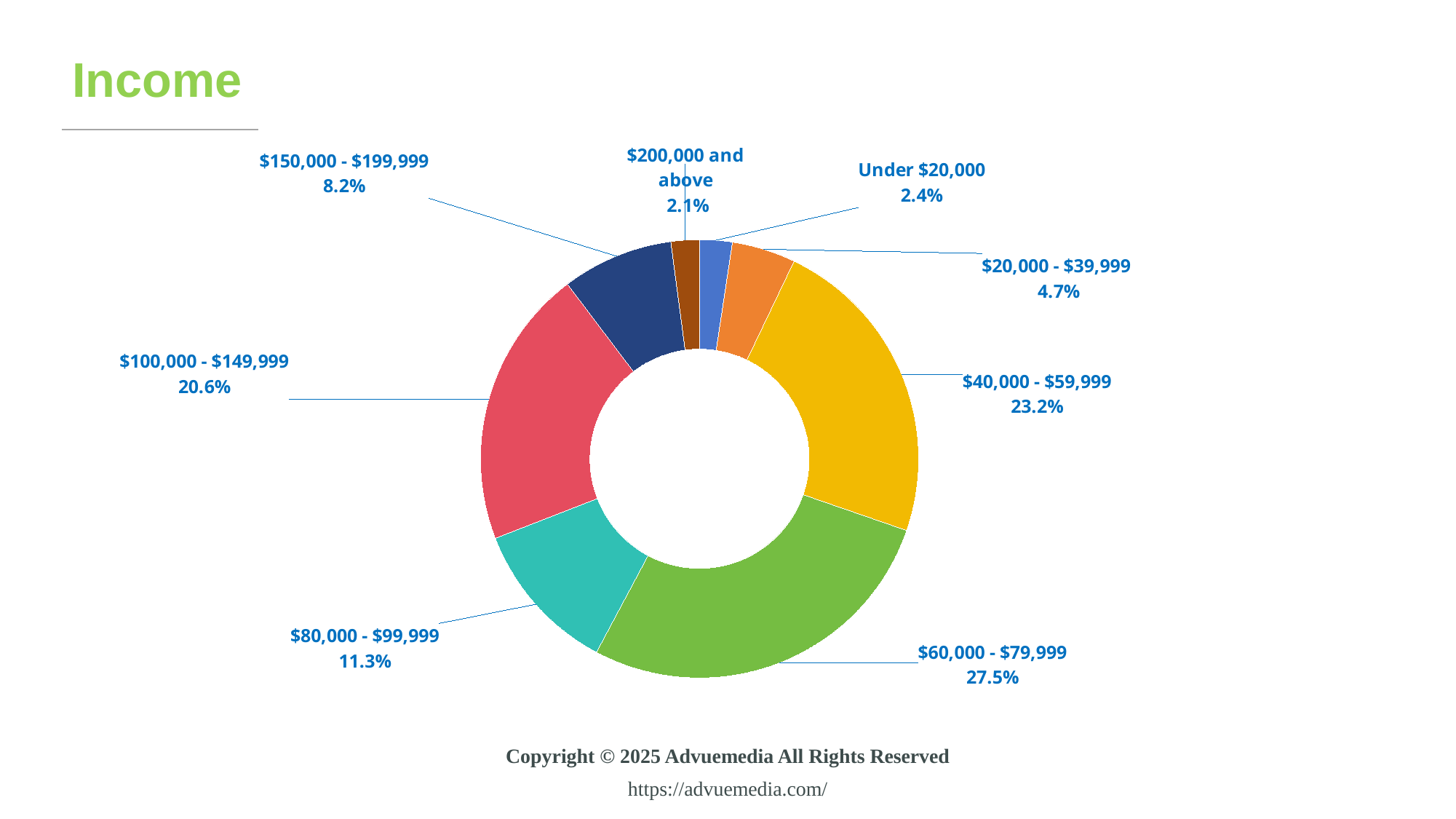
Which income category has the largest share? $60,000 - $79,999 What is the title of the slide? Income What is the difference between the $40,000 - $59,999 share and the $80,000 - $99,999 share? 11.9% Which is larger, the share for $150,000 - $199,999 or the share for $20,000 - $39,999? $150,000 - $199,999 How many income categories are shown in the chart? 8 What share of the Income chart is the $60,000 - $79,999 category? 27.5% What colour is the $40,000 - $59,999 slice? Yellow What kind of chart is shown on the slide? Pie chart (doughnut) Which income category has the smallest share? $200,000 and above What is the combined share of the $100,000 - $149,999 and $150,000 - $199,999 categories? 28.8% What is the value for the Under $20,000 category? 2.4% What percentage is shown for the $100,000 - $149,999 slice? 20.6%